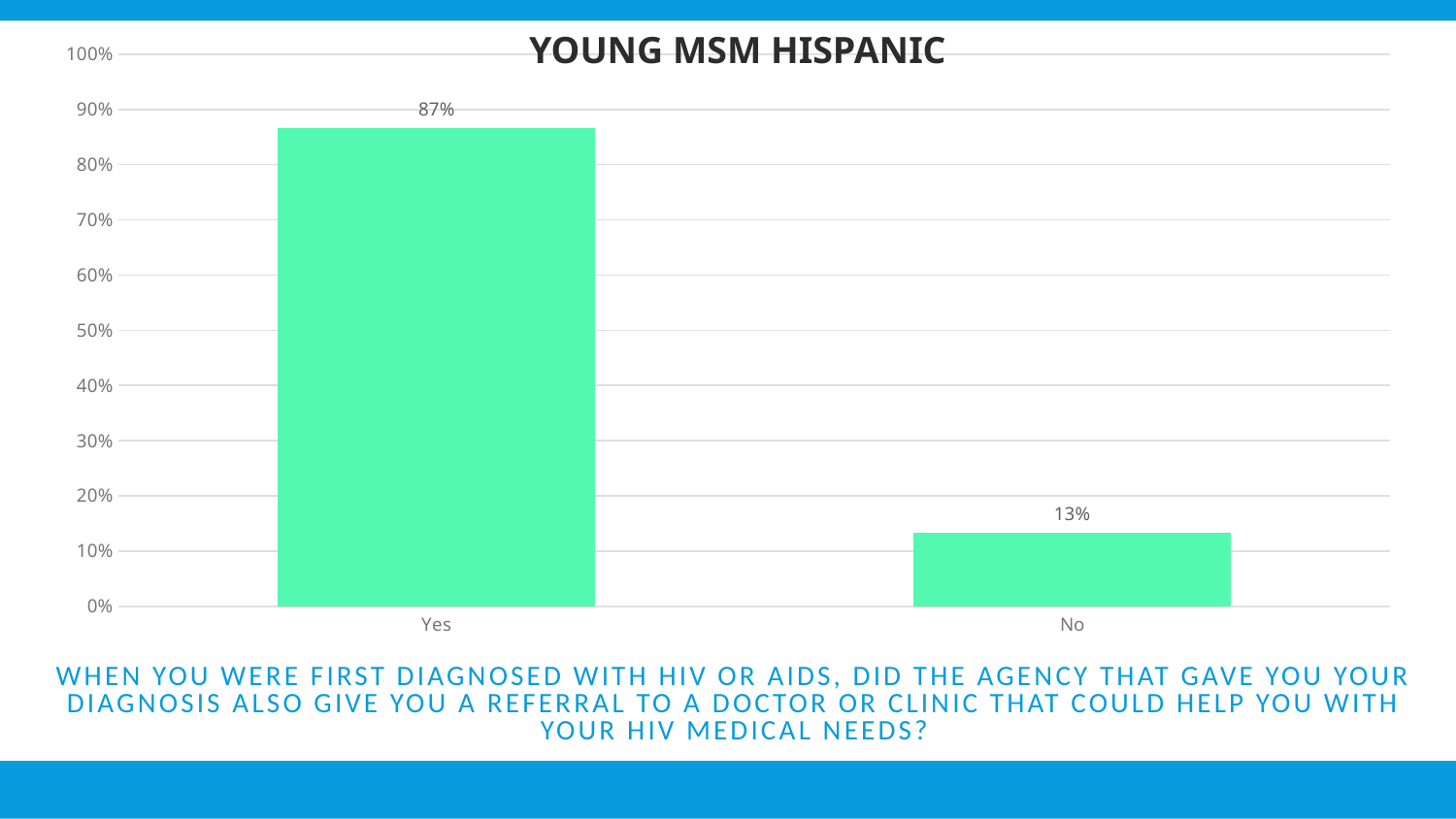
What is the title of the chart? YOUNG MSM HISPANIC Which category has the lowest value? No Which is larger, the value for Yes or the value for No? Yes What is the value for Yes? 87% Which category has the highest value? Yes What is the difference between the values for Yes and No? 74% Is the value for Yes greater or less than 80%? greater Is the value for No greater or less than 20%? less What is the highest value shown on the y axis? 100% How many categories are shown on the x axis? 2 What kind of chart is shown on the slide? bar chart What is the value for No? 13%